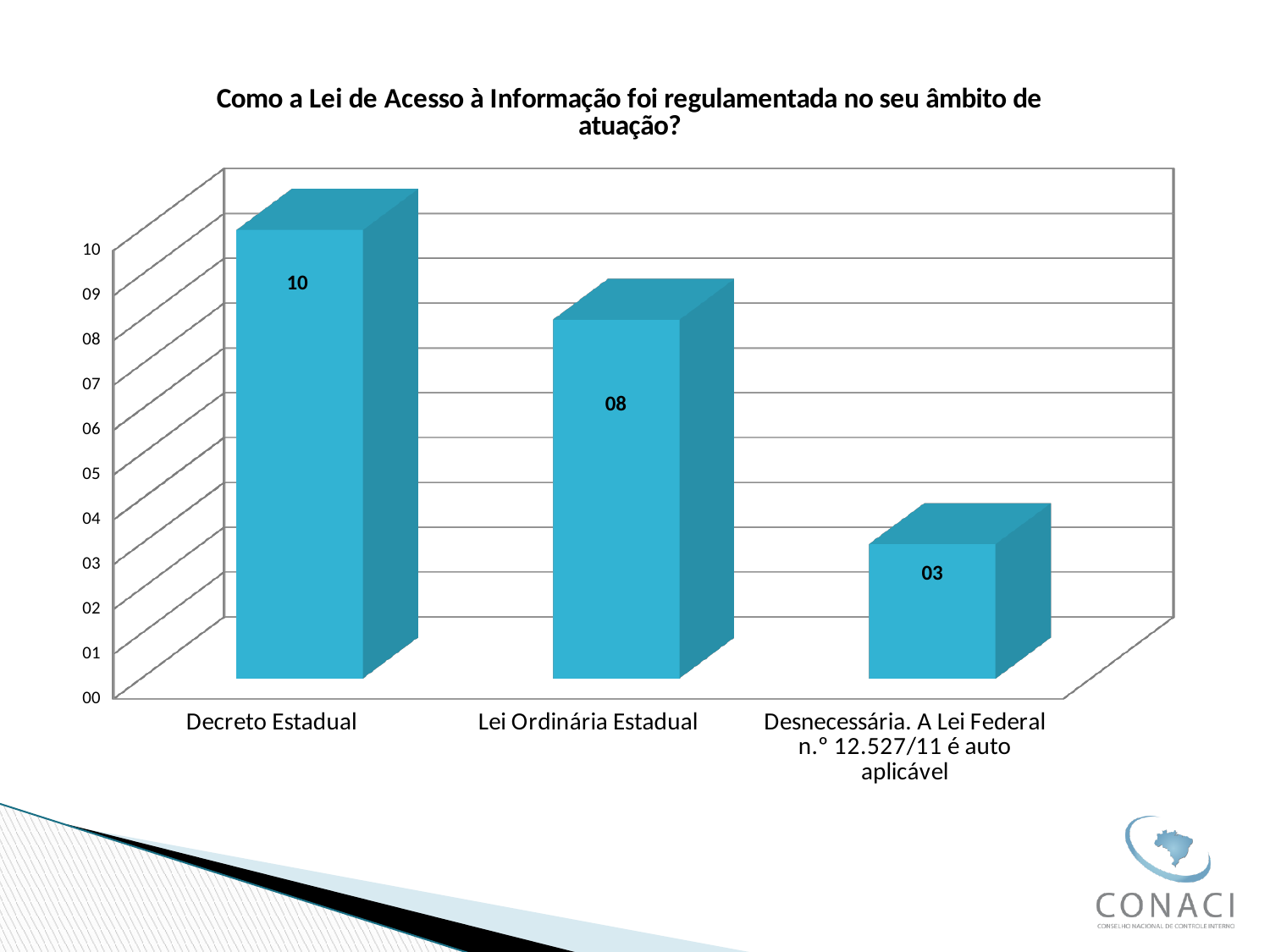
How many categories are shown in the chart? 3 What kind of chart is shown on the slide? Bar chart Do the values rise or fall from left to right across the categories? Fall What is the value for the category 'Desnecessária. A Lei Federal n.° 12.527/11 é auto aplicável'? 03 Which category has the highest value? Decreto Estadual Which is larger, the value for Lei Ordinária Estadual or the value for 'Desnecessária. A Lei Federal n.° 12.527/11 é auto aplicável'? Lei Ordinária Estadual What is the title of the chart? Como a Lei de Acesso à Informação foi regulamentada no seu âmbito de atuação? What is the value for Decreto Estadual? 10 What is the difference between the values for Decreto Estadual and Lei Ordinária Estadual? 2 What is the difference between the values for Lei Ordinária Estadual and 'Desnecessária. A Lei Federal n.° 12.527/11 é auto aplicável'? 5 Which category has the lowest value? Desnecessária. A Lei Federal n.° 12.527/11 é auto aplicável What is the value for Lei Ordinária Estadual? 08